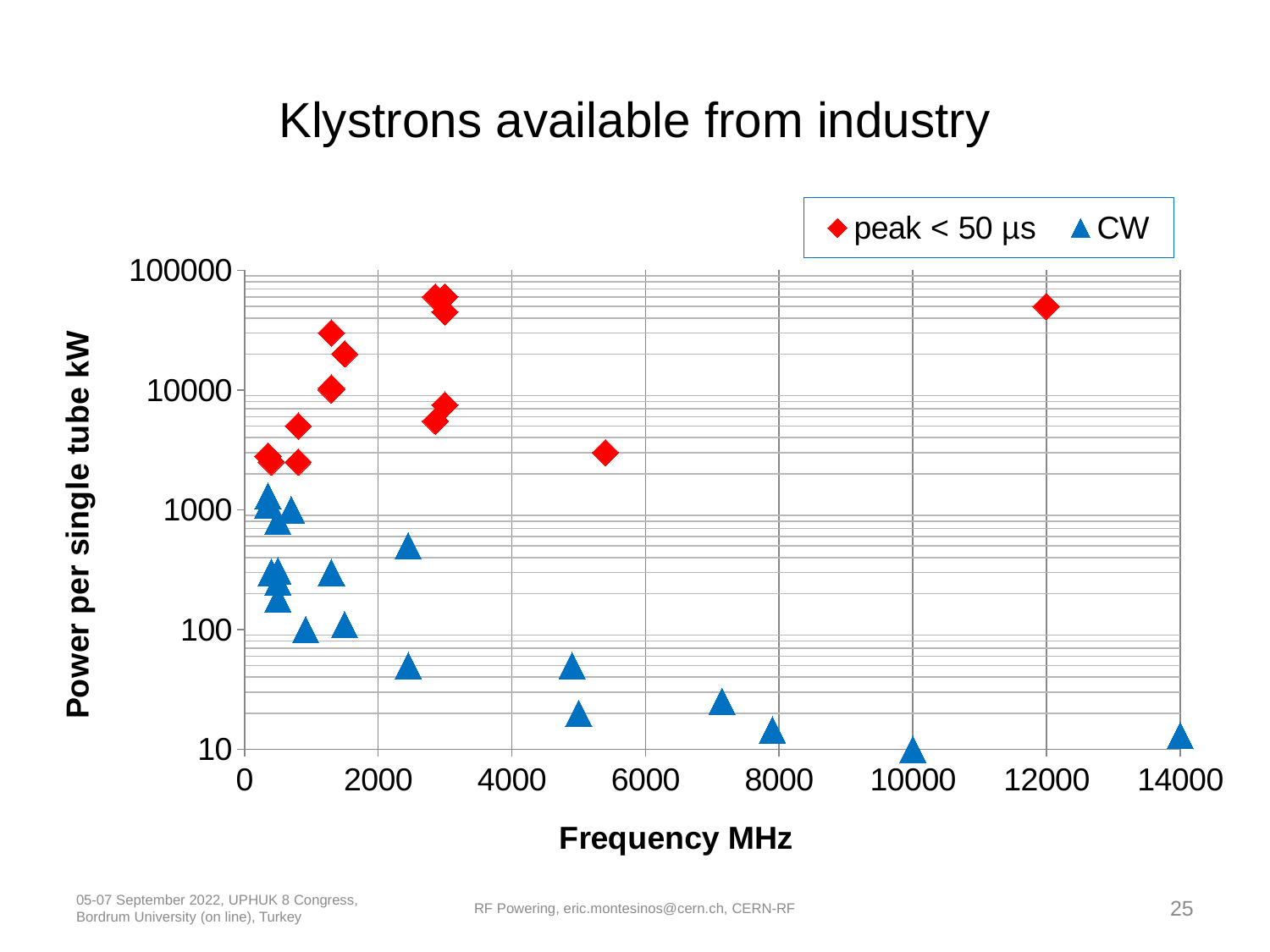
Is the power for the CW point near 14000 MHz greater or less than 100? less What kind of chart is shown on the slide? scatter chart What is the label of the x axis? Frequency MHz Is the power for the CW point near 10000 MHz greater or less than 100? less Do the CW power values generally rise or fall as frequency increases? fall Is the power for the CW point near 7900 MHz greater or less than 100? less How many series does the legend list? 2 Which series has the point with the highest power on the chart? peak < 50 µs Which series reaches higher power values, peak < 50 µs or CW? peak < 50 µs What is the title of the chart? Klystrons available from industry